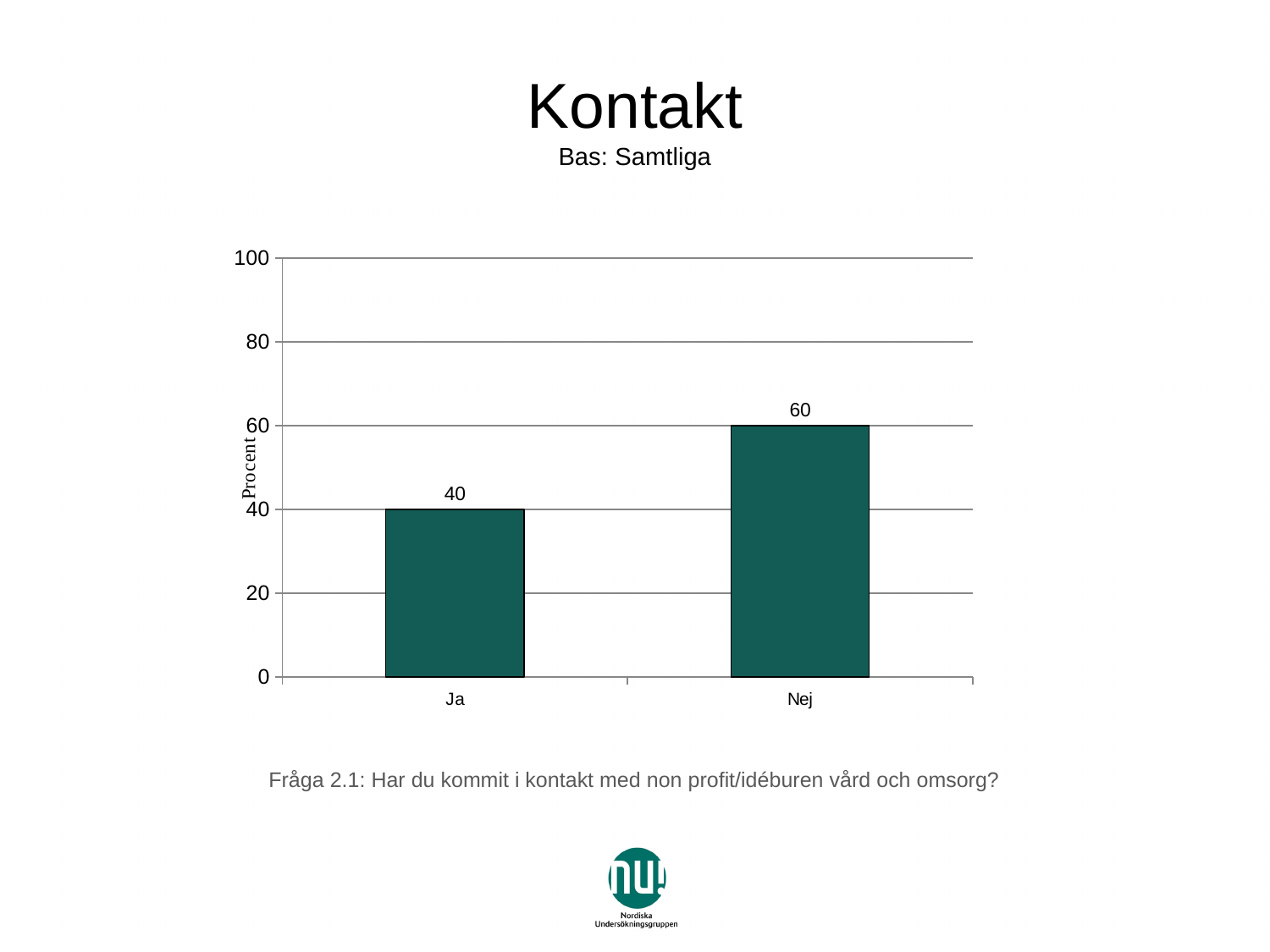
Which category has the highest value? Nej Which category has the lowest value? Ja Which is larger, the value for Ja or the value for Nej? Nej What is the title of the slide? Kontakt What is the value for Ja? 40 What is the value for Nej? 60 How many categories are shown on the x axis? 2 What is the label of the y axis? Procent What is the difference between the values for Nej and Ja? 20 Is the value for Nej greater or less than 80? less What kind of chart is shown on the slide? bar chart What is the total of the values for Ja and Nej? 100